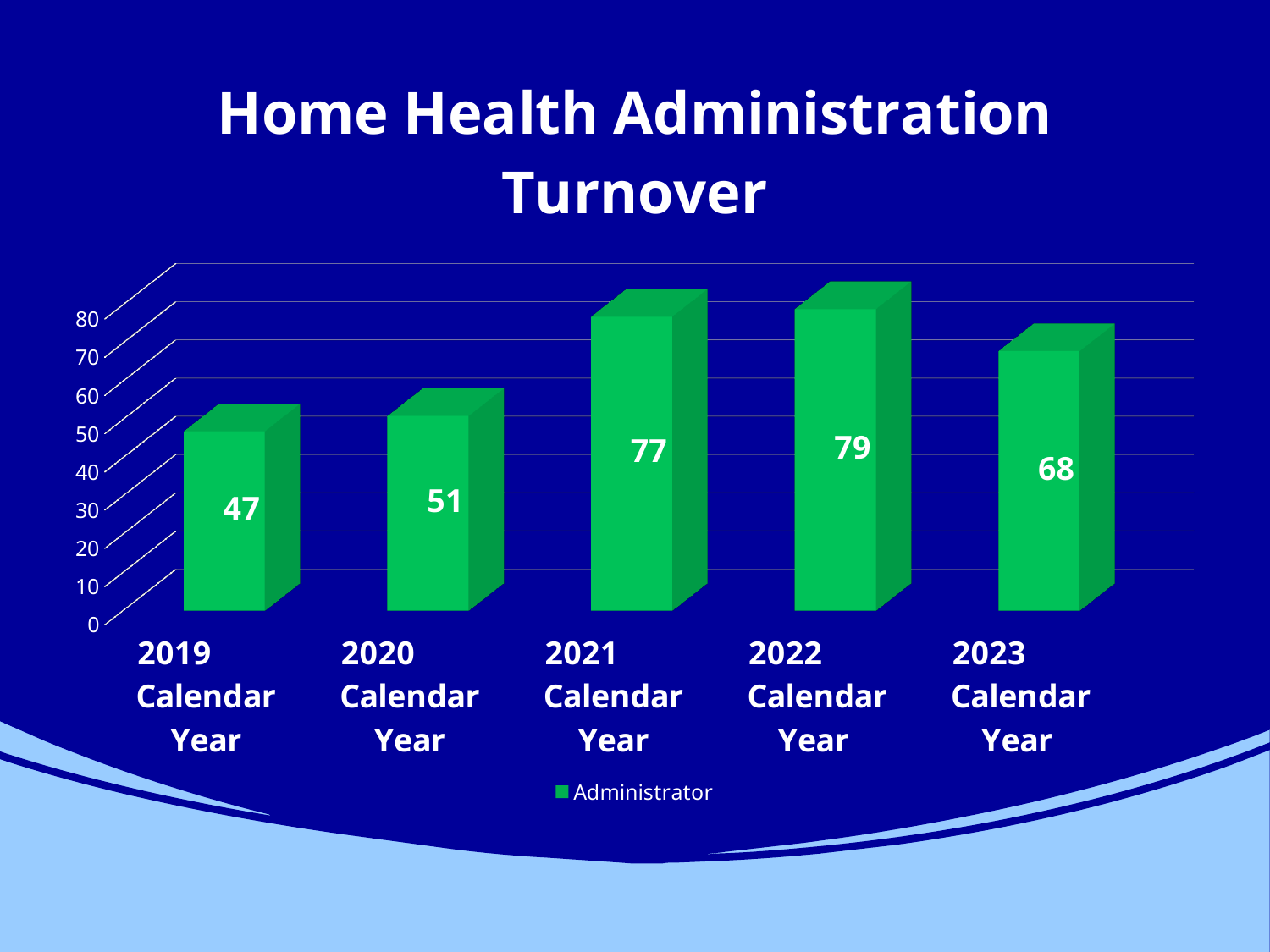
What is the Administrator turnover value for the 2023 Calendar Year? 68 What is the Administrator turnover value for the 2019 Calendar Year? 47 What is the difference between the Administrator turnover values for the 2022 Calendar Year and the 2019 Calendar Year? 32 What is the title of the chart? Home Health Administration Turnover Which is larger, the Administrator turnover value for the 2021 Calendar Year or the 2023 Calendar Year? 2021 Calendar Year What is the Administrator turnover value for the 2022 Calendar Year? 79 How many series does the legend list? 1 Which calendar year has the lowest Administrator turnover value? 2019 Calendar Year What is the difference between the Administrator turnover values for the 2021 Calendar Year and the 2020 Calendar Year? 26 Which calendar year has the highest Administrator turnover value? 2022 Calendar Year What kind of chart is shown on the slide? Bar chart How many calendar years are shown on the chart? 5